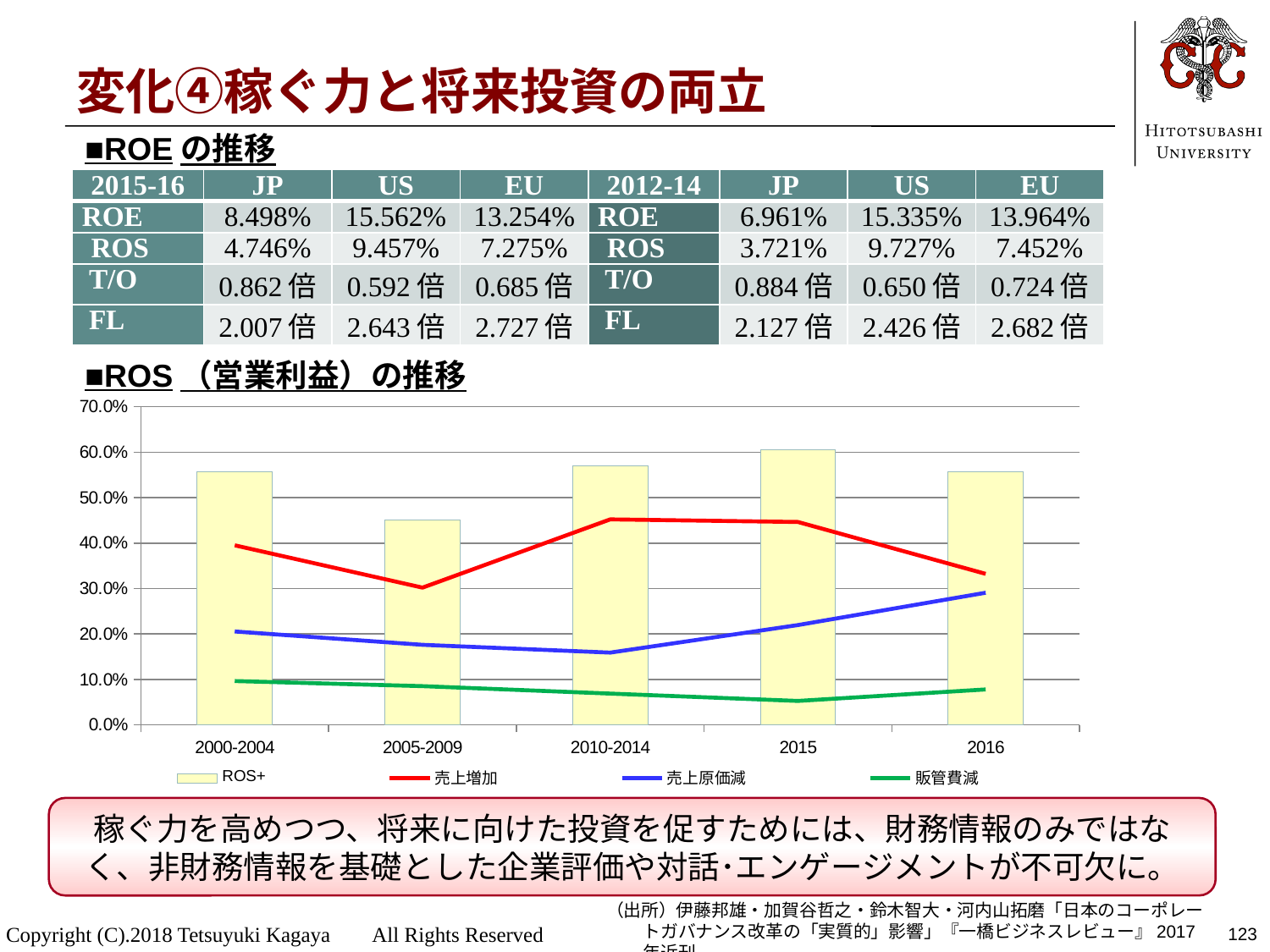
How many series does the legend of the ROS chart list? 4 In the ROS chart, is the 販管費減 value for 2015 greater or less than 10.0%? less In the ROS chart, which is larger for 2016: 売上増加 or 売上原価減? 売上増加 In the ROS chart, which period has the highest ROS+ bar? 2015 In the ROS chart, which period has the highest 売上原価減 value? 2016 In the ROS chart, which period has the lowest ROS+ bar? 2005-2009 In the ROS chart, is the 売上増加 value for 2010-2014 greater or less than 40.0%? greater How many period categories are shown on the x axis of the ROS chart? 5 What kind of chart is shown under the heading ROS（営業利益）の推移? A combined bar and line chart In the ROS chart, does the 売上原価減 line rise or fall from 2010-2014 to 2016? rise In the ROS chart, which period has the lowest 販管費減 value? 2015 In the ROS chart, is the ROS+ value for 2005-2009 greater or less than 50.0%? less